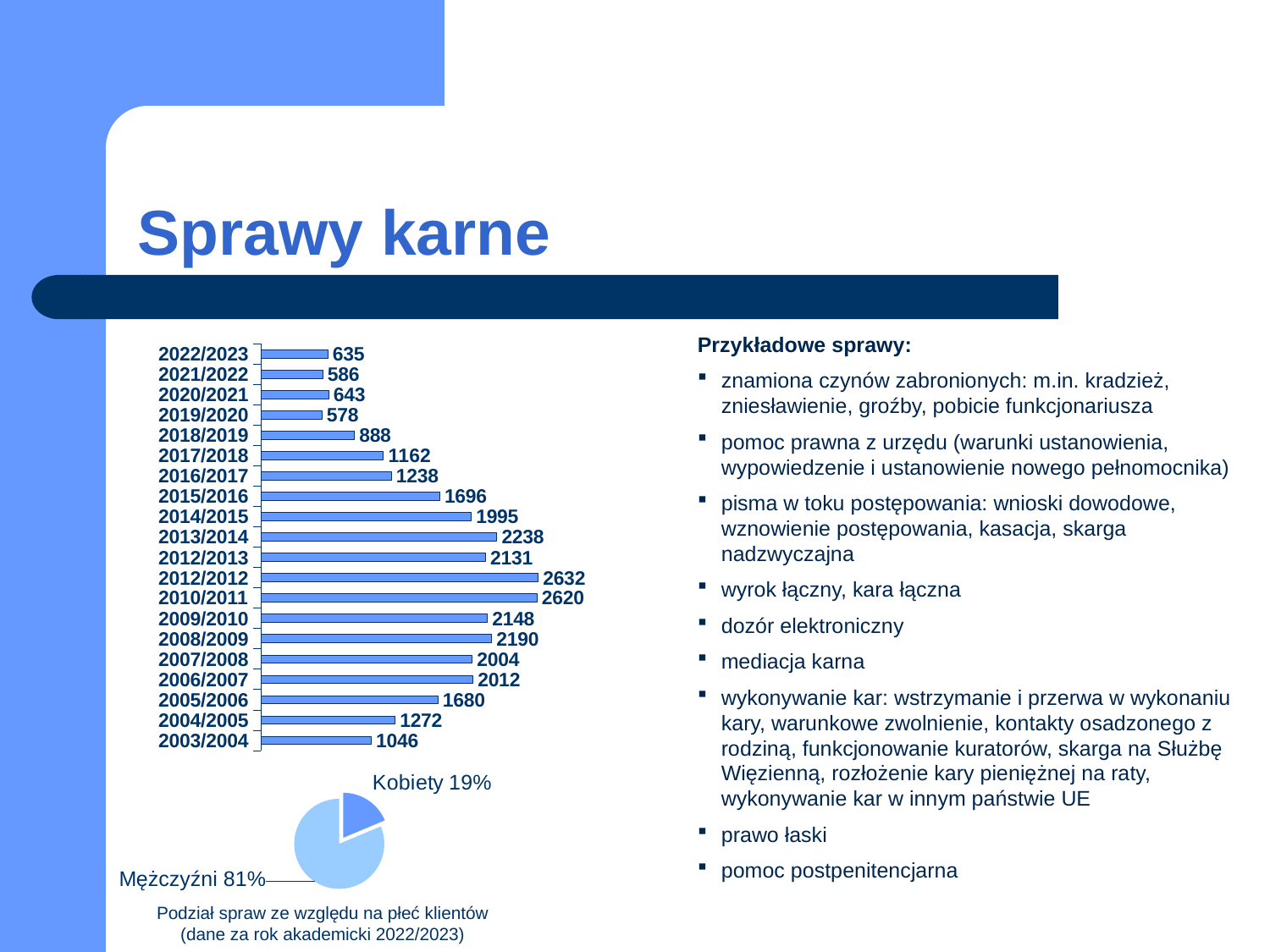
In the bar chart, which academic year has the lowest value? 2019/2020 How many academic years are shown in the bar chart? 20 What is the caption below the pie chart? Podział spraw ze względu na płeć klientów (dane za rok akademicki 2022/2023) In the bar chart, what is the value for 2010/2011? 2620 In the bar chart, which is larger, the value for 2015/2016 or the value for 2005/2006? 2015/2016 In the pie chart, what share is labelled Mężczyźni? 81% In the pie chart, what share is labelled Kobiety? 19% In the bar chart, what is the difference between the values for 2013/2014 and 2012/2013? 107 What kind of chart is the upper chart on the slide? Bar chart In the bar chart, which academic year has the highest value? 2012/2012 In the bar chart, what is the value for 2022/2023? 635 In the bar chart, do the values rise or fall from 2016/2017 to 2022/2023? Fall